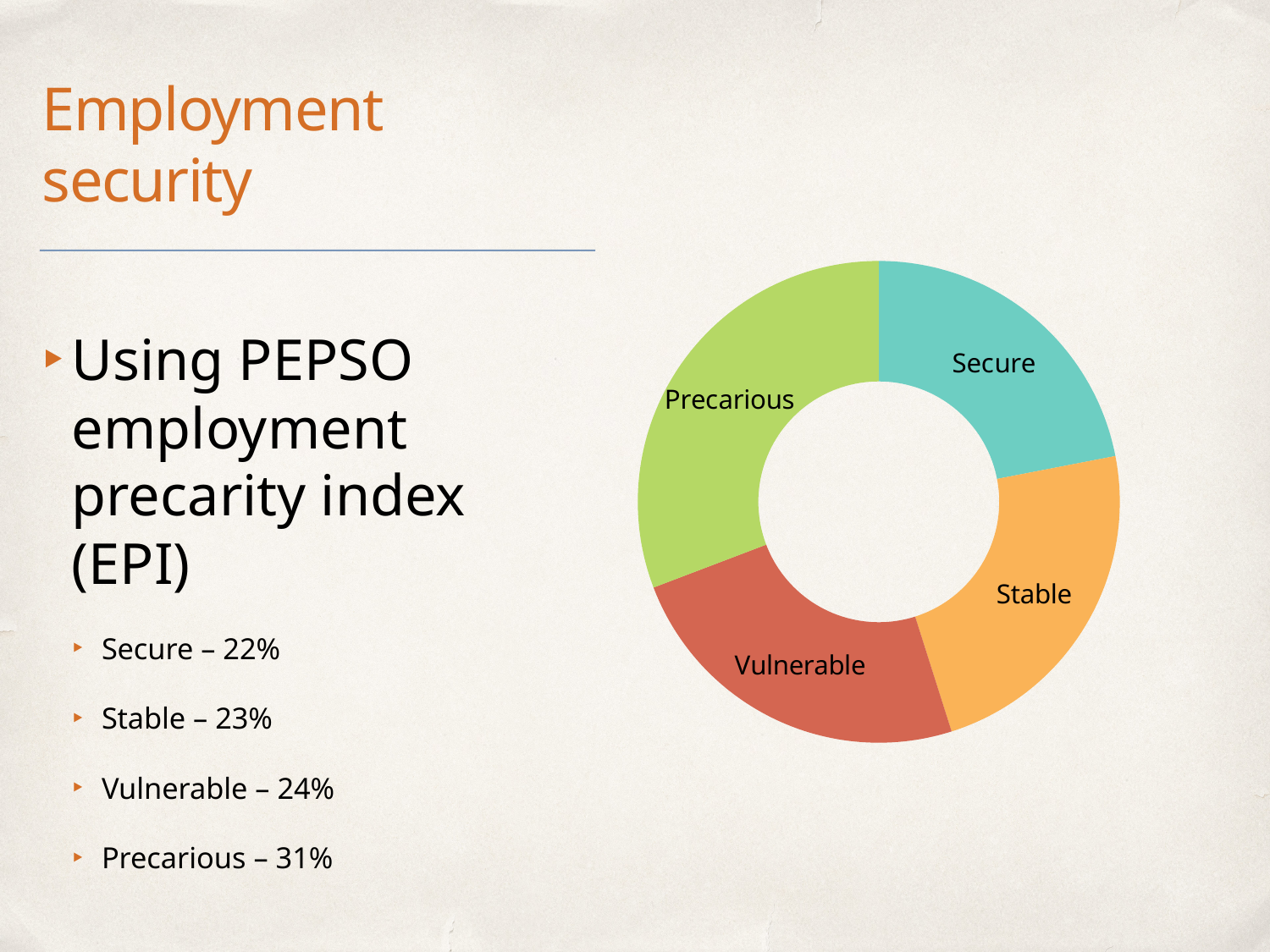
How many categories are shown in the chart? 4 What is the difference between the Vulnerable and Stable values? 1% What is the value for the Precarious segment? 31% Which category has the largest segment in the chart? Precarious What share of the doughnut chart is labelled Secure? 22% Which is larger, the Precarious segment or the Secure segment? Precarious Which is larger, the Precarious segment or the Vulnerable segment? Precarious What kind of chart is shown on the slide? doughnut chart What colour is the Vulnerable segment of the chart? red What is the difference between the Precarious and Secure values? 9% What percentage does the Vulnerable segment represent? 24% What is the value for the Stable segment of the chart? 23%